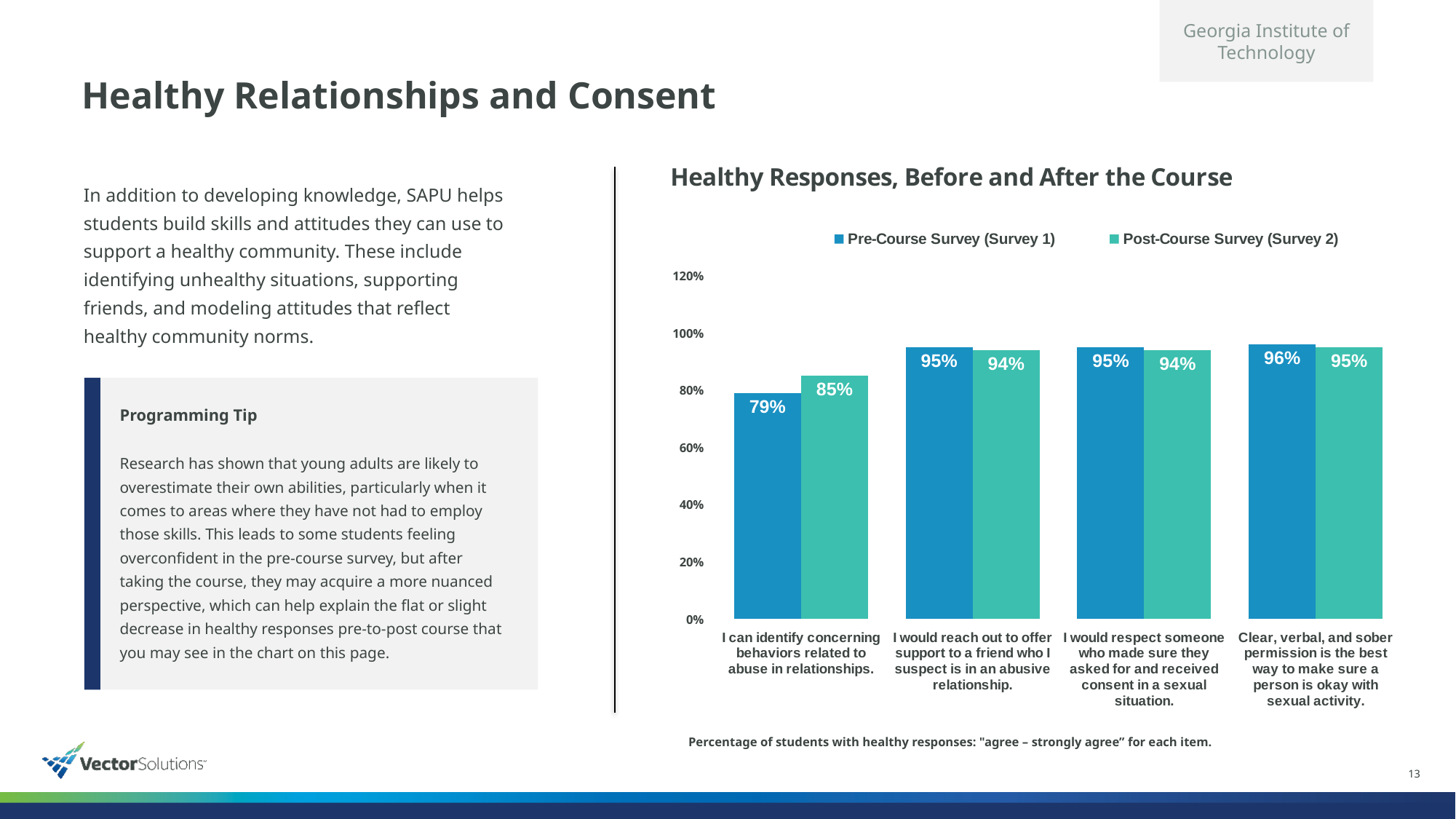
Which category has the highest Pre-Course Survey (Survey 1) value? Clear, verbal, and sober permission is the best way to make sure a person is okay with sexual activity. For "I would respect someone who made sure they asked for and received consent in a sexual situation.", which is larger: the Pre-Course Survey value or the Post-Course Survey value? Pre-Course Survey (Survey 1) What is the Pre-Course Survey (Survey 1) value for "I can identify concerning behaviors related to abuse in relationships."? 79% What is the difference between the Post-Course and Pre-Course Survey values for "I can identify concerning behaviors related to abuse in relationships."? 6% How many categories are shown on the x axis of the chart? 4 What is the Pre-Course Survey (Survey 1) value for "Clear, verbal, and sober permission is the best way to make sure a person is okay with sexual activity."? 96% What is the Post-Course Survey (Survey 2) value for "I would reach out to offer support to a friend who I suspect is in an abusive relationship."? 94% What kind of chart is shown on the slide? Bar chart What is the title of the chart? Healthy Responses, Before and After the Course What is the Post-Course Survey (Survey 2) value for "I can identify concerning behaviors related to abuse in relationships."? 85% How many series does the chart's legend list? 2 Which category has the lowest Pre-Course Survey (Survey 1) value? I can identify concerning behaviors related to abuse in relationships.